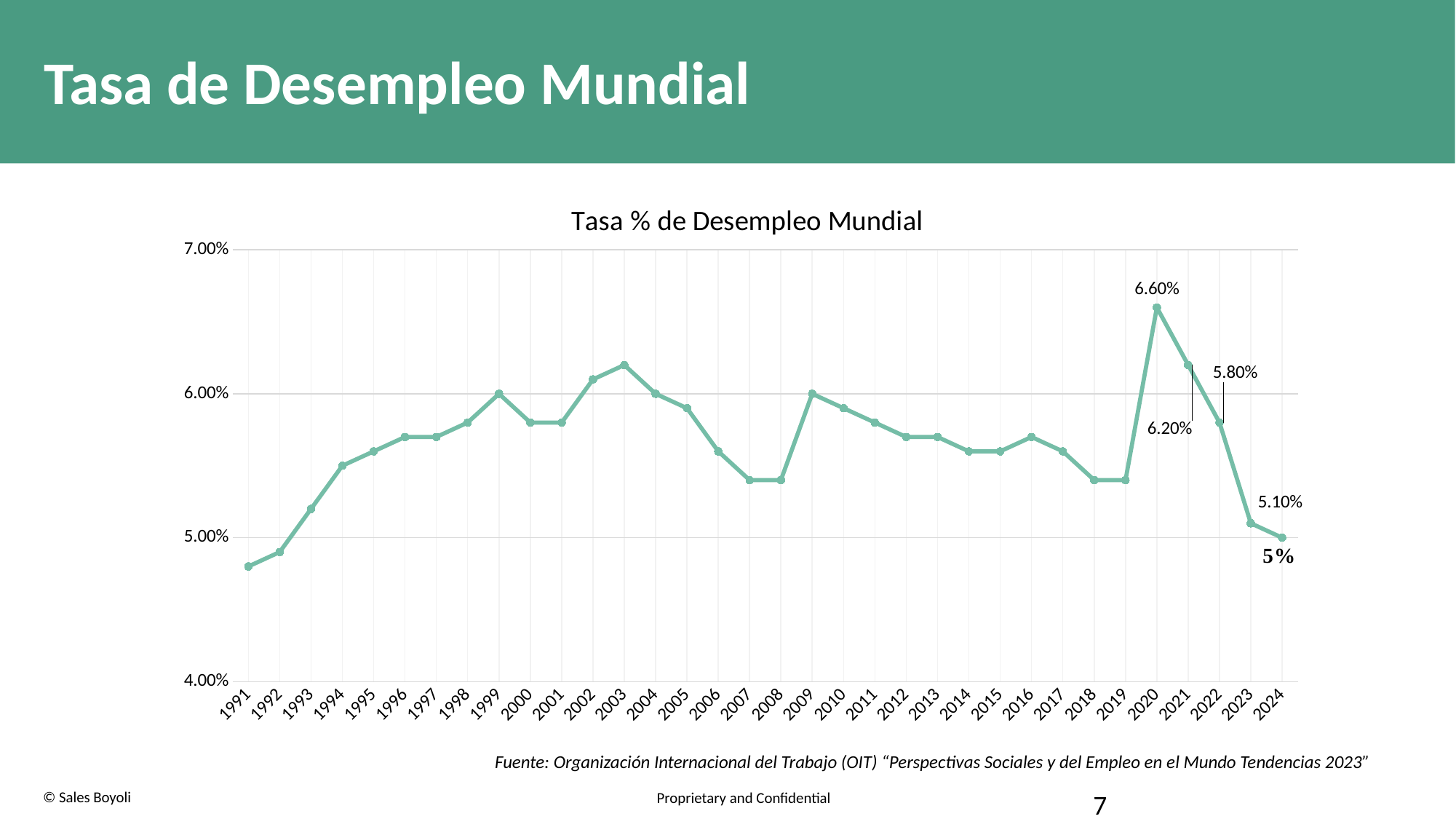
Do the values rise or fall from 2020 to 2024? fall What is the value for 2020? 6.60% What type of chart is shown on the slide? Line chart What is the value for 2023? 5.10% What is the value for 2022? 5.80% Which year has the highest unemployment rate? 2020 What is the value for 2021? 6.20% Is the value for 2003 greater or less than 6.00%? greater What is the title of the chart? Tasa % de Desempleo Mundial What is the difference between the values for 2020 and 2021? 0.40% Which year has the lowest unemployment rate? 1991 Is the value for 1991 greater or less than 5.00%? less